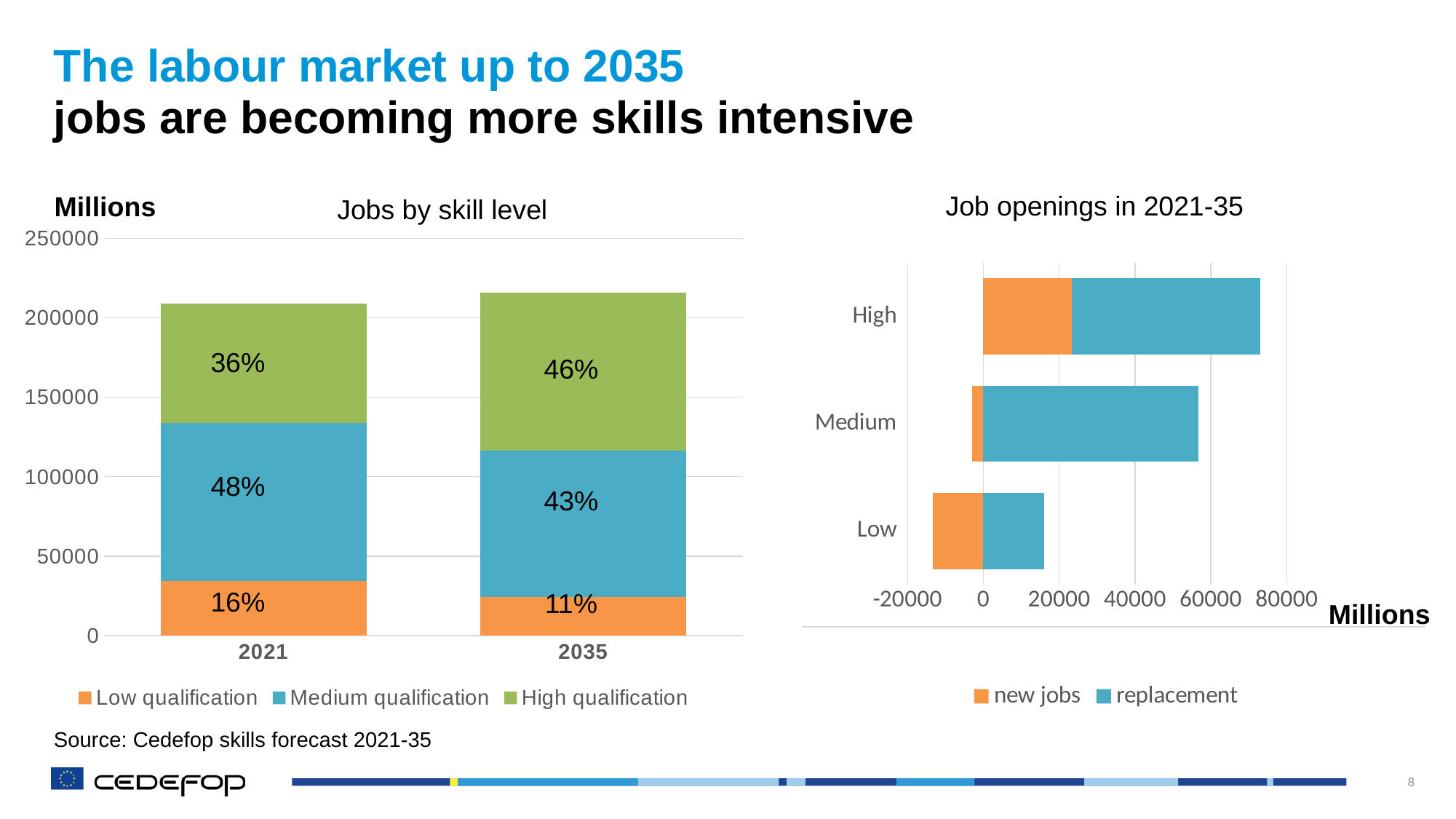
In the 'Job openings in 2021-35' chart, is the value for new jobs in the Low category greater or less than 0? less In the 'Jobs by skill level' chart, how many series does the legend list? 3 In the 'Jobs by skill level' chart, which qualification level has the largest share in 2021? Medium qualification In the 'Job openings in 2021-35' chart, which category has the largest total job openings? High In the 'Jobs by skill level' chart, what share of jobs is labelled for Medium qualification in 2035? 43% In the 'Jobs by skill level' chart, what share of jobs is labelled for Low qualification in 2021? 16% In the 'Job openings in 2021-35' chart, how many skill-level categories are shown? 3 In the 'Jobs by skill level' chart, by how many percentage points does the High qualification share change from 2021 to 2035? 10 percentage points In the 'Jobs by skill level' chart, which qualification level has the smallest share in 2035? Low qualification In the 'Job openings in 2021-35' chart, is the total job openings for Medium greater or less than 40000? greater In the 'Jobs by skill level' chart, what share of jobs is labelled for High qualification in 2035? 46% What kind of chart is 'Job openings in 2021-35'? Bar chart